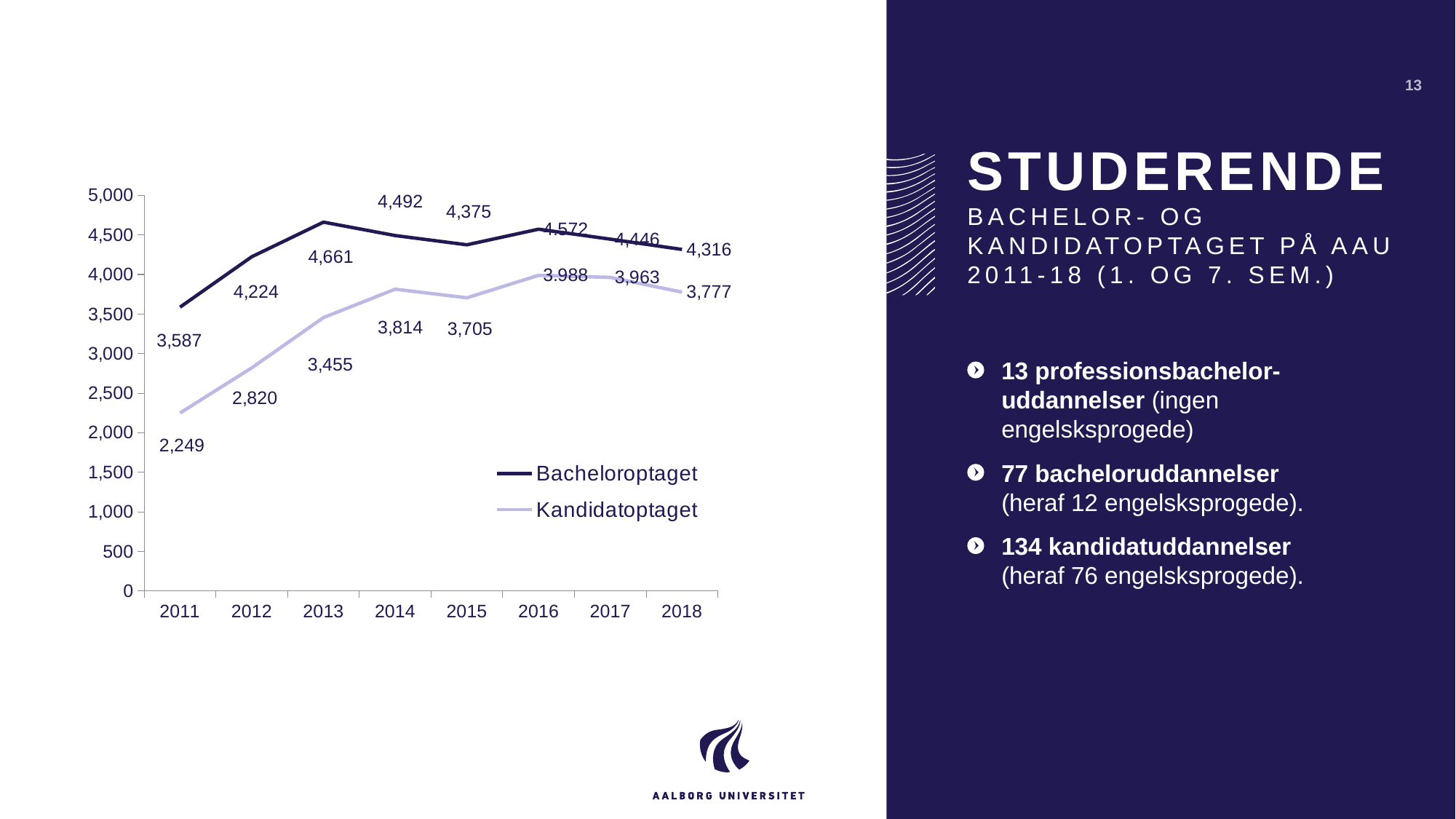
What is the value for Kandidatoptaget in 2018? 3,777 How many years are shown on the x axis? 8 What is the value for Kandidatoptaget in 2011? 2,249 Which series is drawn in the lighter colour? Kandidatoptaget Which is larger in 2015: Bacheloroptaget or Kandidatoptaget? Bacheloroptaget What type of chart is shown on the slide? line chart In which year is Kandidatoptaget lowest? 2011 What is the difference between Bacheloroptaget and Kandidatoptaget in 2018? 539 In which year is Bacheloroptaget highest? 2013 What is the value for Bacheloroptaget in 2013? 4,661 How many series does the legend list? 2 Does Kandidatoptaget rise or fall from 2011 to 2014? rise